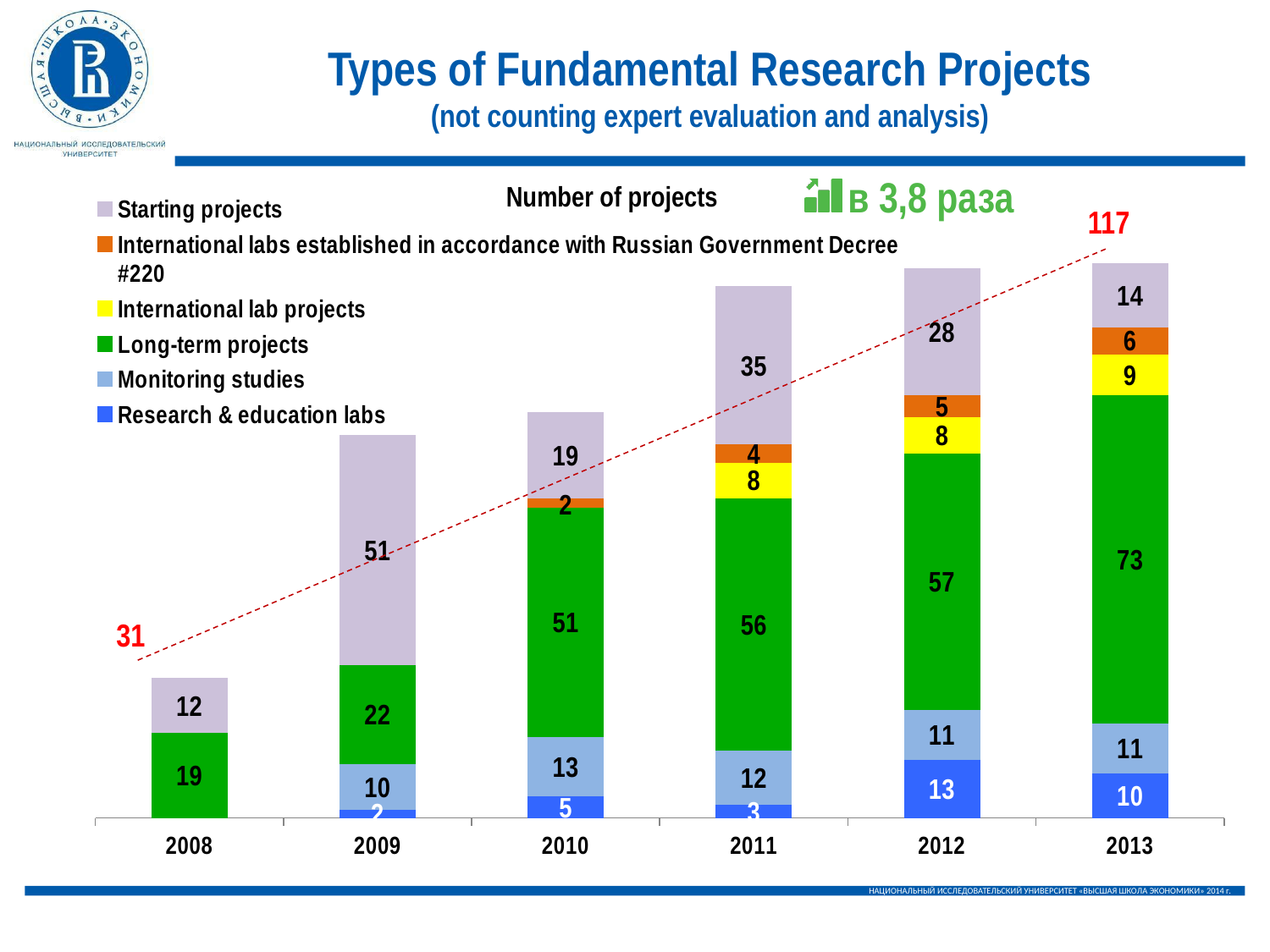
What is the number of Starting projects in 2009? 51 What kind of chart is shown on the slide? Stacked bar chart What is the difference between Long-term projects in 2013 and in 2008? 54 Which year has more Monitoring studies, 2010 or 2011? 2010 Do the values for Long-term projects rise or fall from 2008 to 2013? Rise In which year is the number of Long-term projects highest? 2013 How many series does the legend list? 6 What is the number of Long-term projects in 2013? 73 What is the total number of projects in the 2008 bar? 31 How many years are shown on the x axis? 6 What is the number of Research & education labs in 2012? 13 In which year is the number of Starting projects highest? 2009